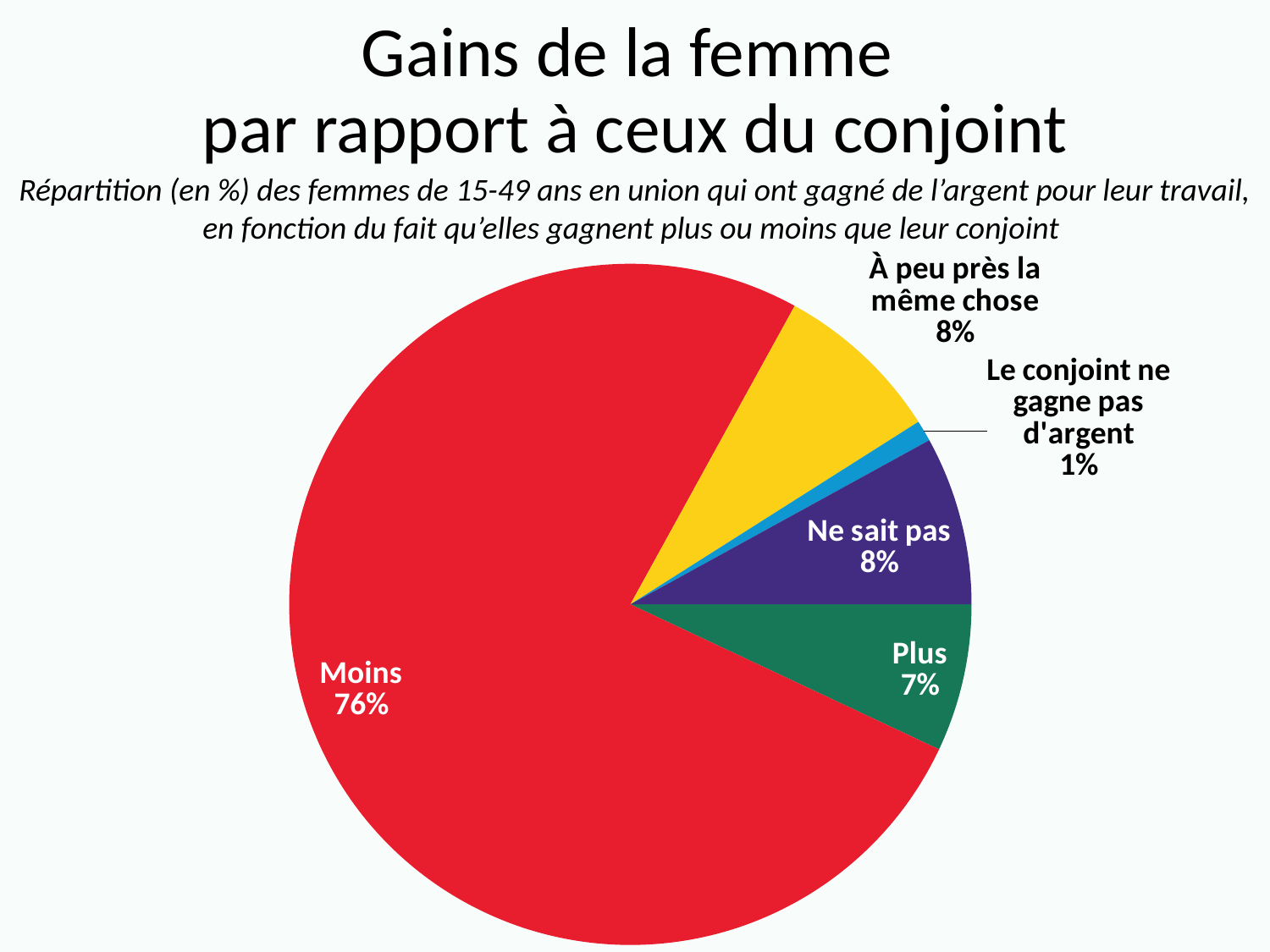
What percentage of women earn more ("Plus") than their partner? 7% What colour is the "Moins" slice? Red What is the value for "Ne sait pas"? 8% Which is larger, the share for "Plus" or the share for "Ne sait pas"? Ne sait pas Which category has the smallest share of the pie? Le conjoint ne gagne pas d'argent What is the difference between the "Moins" share and the "Plus" share? 69 percentage points What percentage of women earn less ("Moins") than their partner? 76% What kind of chart is shown on the slide? Pie chart How many slices does the pie chart have? 5 What is the value for "Le conjoint ne gagne pas d'argent"? 1% What is the value for "À peu près la même chose"? 8% Which category has the largest share of the pie? Moins